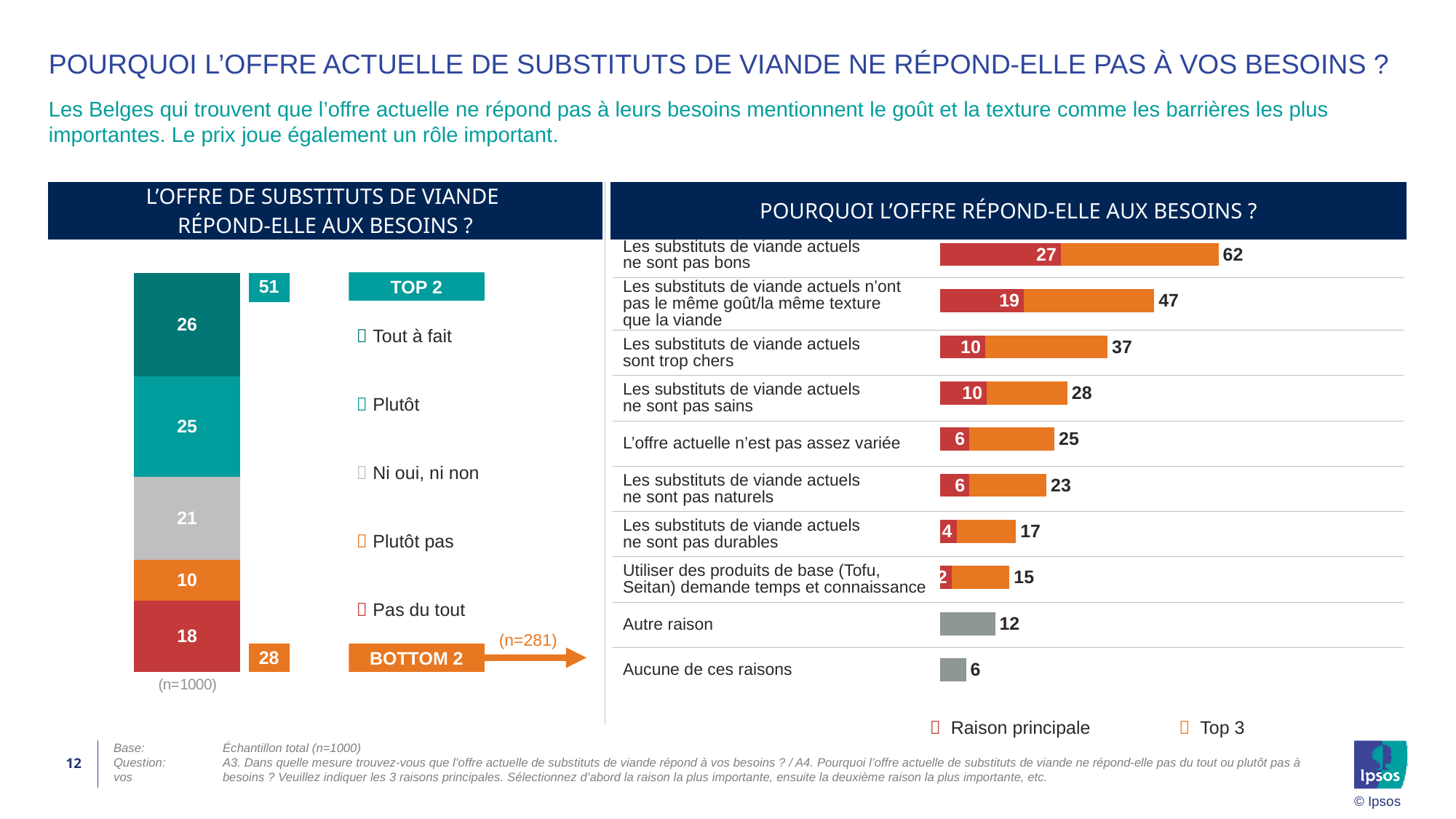
How many series does the legend of the right chart 'POURQUOI L'OFFRE RÉPOND-ELLE AUX BESOINS ?' list? 2 In the right chart 'POURQUOI L'OFFRE RÉPOND-ELLE AUX BESOINS ?', what is the 'Raison principale' value for 'Les substituts de viande actuels sont trop chers'? 10 In the left chart 'L'OFFRE DE SUBSTITUTS DE VIANDE RÉPOND-ELLE AUX BESOINS ?', what is the difference between the TOP 2 and BOTTOM 2 values? 23 In the right chart 'POURQUOI L'OFFRE RÉPOND-ELLE AUX BESOINS ?', what is the difference between the Top 3 values for 'ne sont pas bons' and 'n'ont pas le même goût/la même texture que la viande'? 15 In the left chart 'L'OFFRE DE SUBSTITUTS DE VIANDE RÉPOND-ELLE AUX BESOINS ?', which response category has the lowest value? Plutôt pas In the left chart 'L'OFFRE DE SUBSTITUTS DE VIANDE RÉPOND-ELLE AUX BESOINS ?', what is the value for 'Pas du tout'? 18 In the left chart 'L'OFFRE DE SUBSTITUTS DE VIANDE RÉPOND-ELLE AUX BESOINS ?', what is the value for 'Tout à fait'? 26 How many reasons are listed in the right chart 'POURQUOI L'OFFRE RÉPOND-ELLE AUX BESOINS ?'? 10 In the right chart 'POURQUOI L'OFFRE RÉPOND-ELLE AUX BESOINS ?', which reason has the highest Top 3 value? Les substituts de viande actuels ne sont pas bons In the right chart 'POURQUOI L'OFFRE RÉPOND-ELLE AUX BESOINS ?', what is the Top 3 value for 'Les substituts de viande actuels ne sont pas bons'? 62 In the right chart 'POURQUOI L'OFFRE RÉPOND-ELLE AUX BESOINS ?', which has a larger Top 3 value: 'L'offre actuelle n'est pas assez variée' or 'Les substituts de viande actuels ne sont pas naturels'? L'offre actuelle n'est pas assez variée In the left chart 'L'OFFRE DE SUBSTITUTS DE VIANDE RÉPOND-ELLE AUX BESOINS ?', what is the TOP 2 value? 51